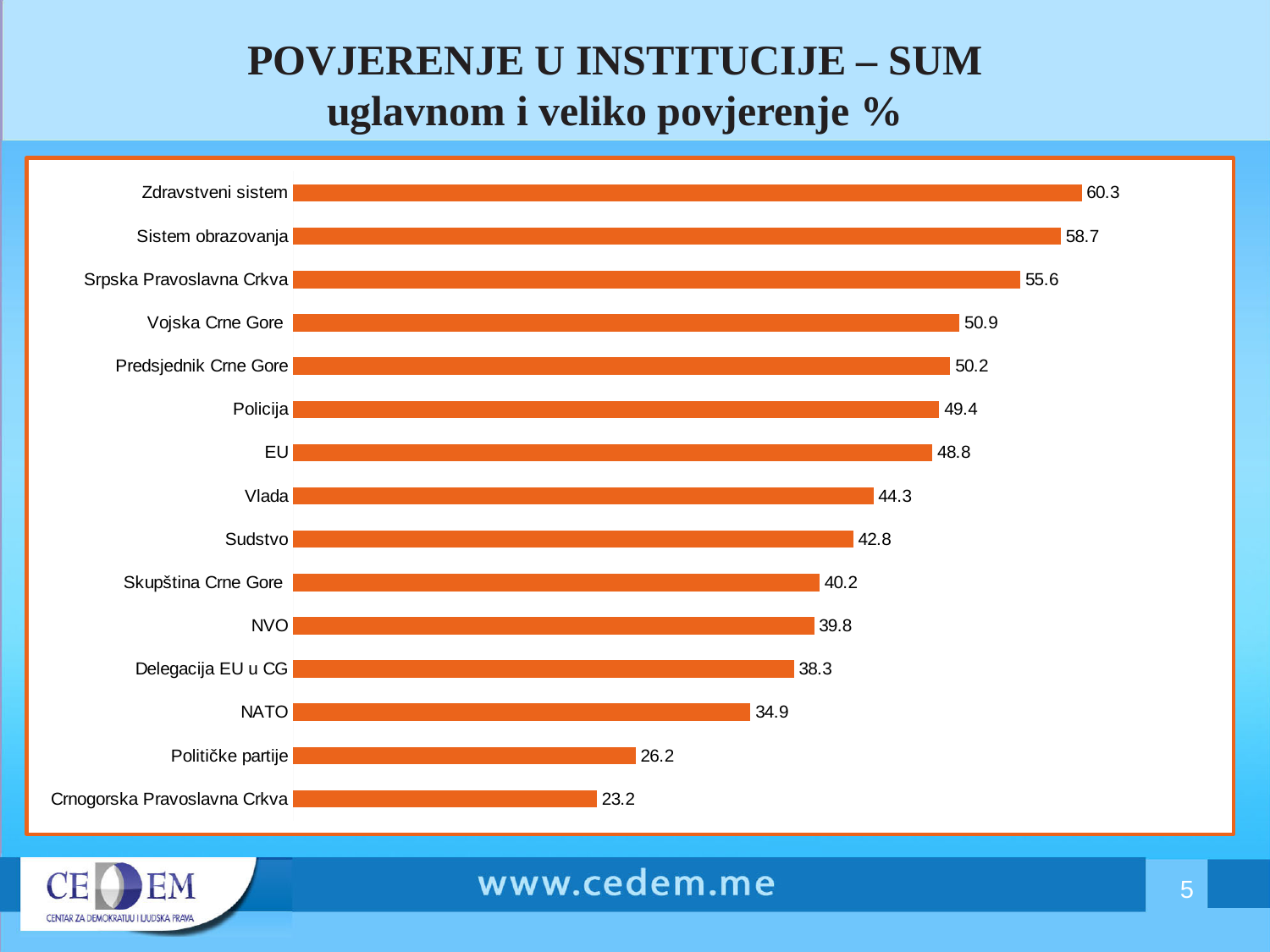
What is the value for Policija? 49.4 Which is larger, the value for NVO or the value for Delegacija EU u CG? NVO Which category has the lowest value? Crnogorska Pravoslavna Crkva Which category has the highest value? Zdravstveni sistem What is the difference between the values for Zdravstveni sistem and Crnogorska Pravoslavna Crkva? 37.1 How many categories are shown in the chart? 15 Which is larger, the value for Srpska Pravoslavna Crkva or the value for Vojska Crne Gore? Srpska Pravoslavna Crkva What is the value for Zdravstveni sistem? 60.3 What is the value for NATO? 34.9 What is the difference between the values for Vlada and Sudstvo? 1.5 What is the title of the chart on the slide? POVJERENJE U INSTITUCIJE – SUM uglavnom i veliko povjerenje % What kind of chart is shown on the slide? Bar chart